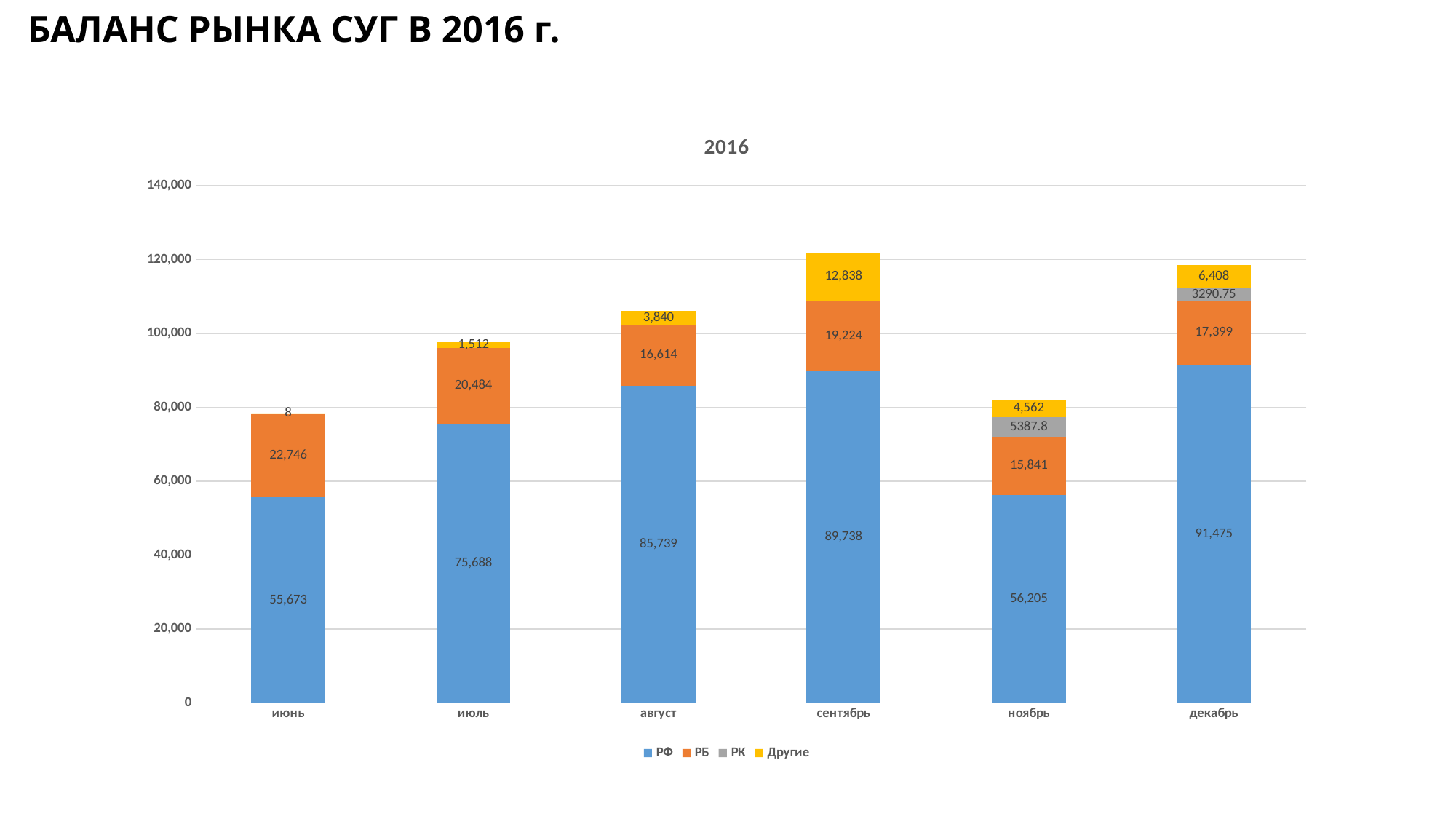
Which is larger, the Другие value for август or for декабрь? декабрь How many series does the legend list? 4 What kind of chart is shown? stacked bar chart Which month has the lowest РБ value? ноябрь What is the value of РБ for июль? 20,484 What is the value of РФ for август? 85,739 What is the difference between the РФ values for декабрь and июнь? 35,802 Is the total stacked bar for август greater or less than 100,000? greater What is the value of Другие for сентябрь? 12,838 What is the value of РК for ноябрь? 5387.8 Which month has the highest РФ value? декабрь How many months are shown on the x axis? 6